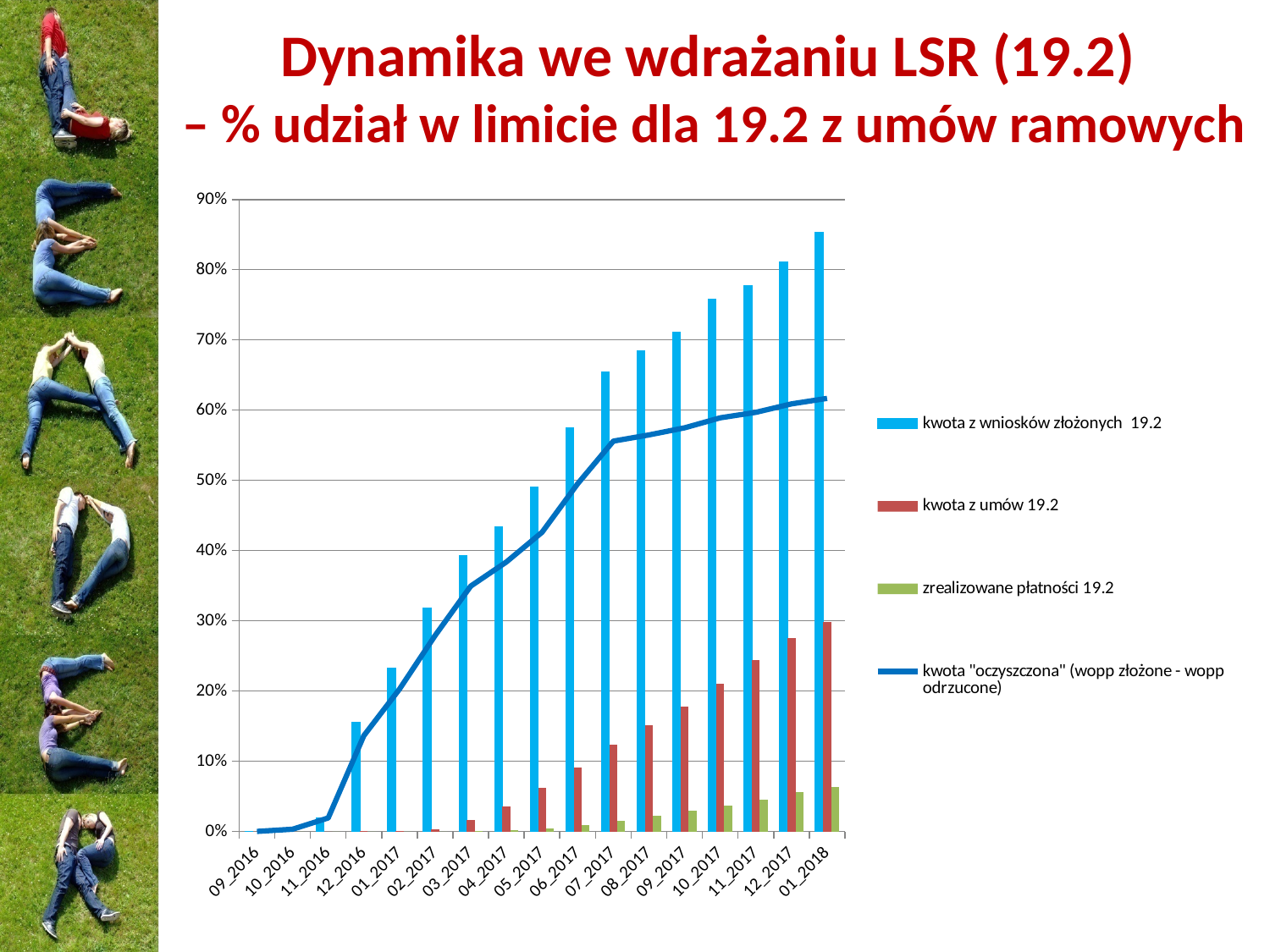
Is the value for 'kwota z wniosków złożonych 19.2' in 12_2016 greater or less than 20%? less Does the value for 'kwota z wniosków złożonych 19.2' rise or fall from 09_2016 to 01_2018? rise In which period is the value for 'kwota z wniosków złożonych 19.2' highest? 01_2018 How many time periods are shown on the x axis? 17 Is the value for 'zrealizowane płatności 19.2' in 01_2018 greater or less than 10%? less How many series does the legend list? 4 What kind of chart is shown on the slide? bar chart with a line Is the value for 'kwota z umów 19.2' in 01_2018 greater or less than 20%? greater In 12_2017, which is larger: 'kwota z wniosków złożonych 19.2' or 'kwota z umów 19.2'? kwota z wniosków złożonych 19.2 What colour represents 'zrealizowane płatności 19.2' in the legend? green